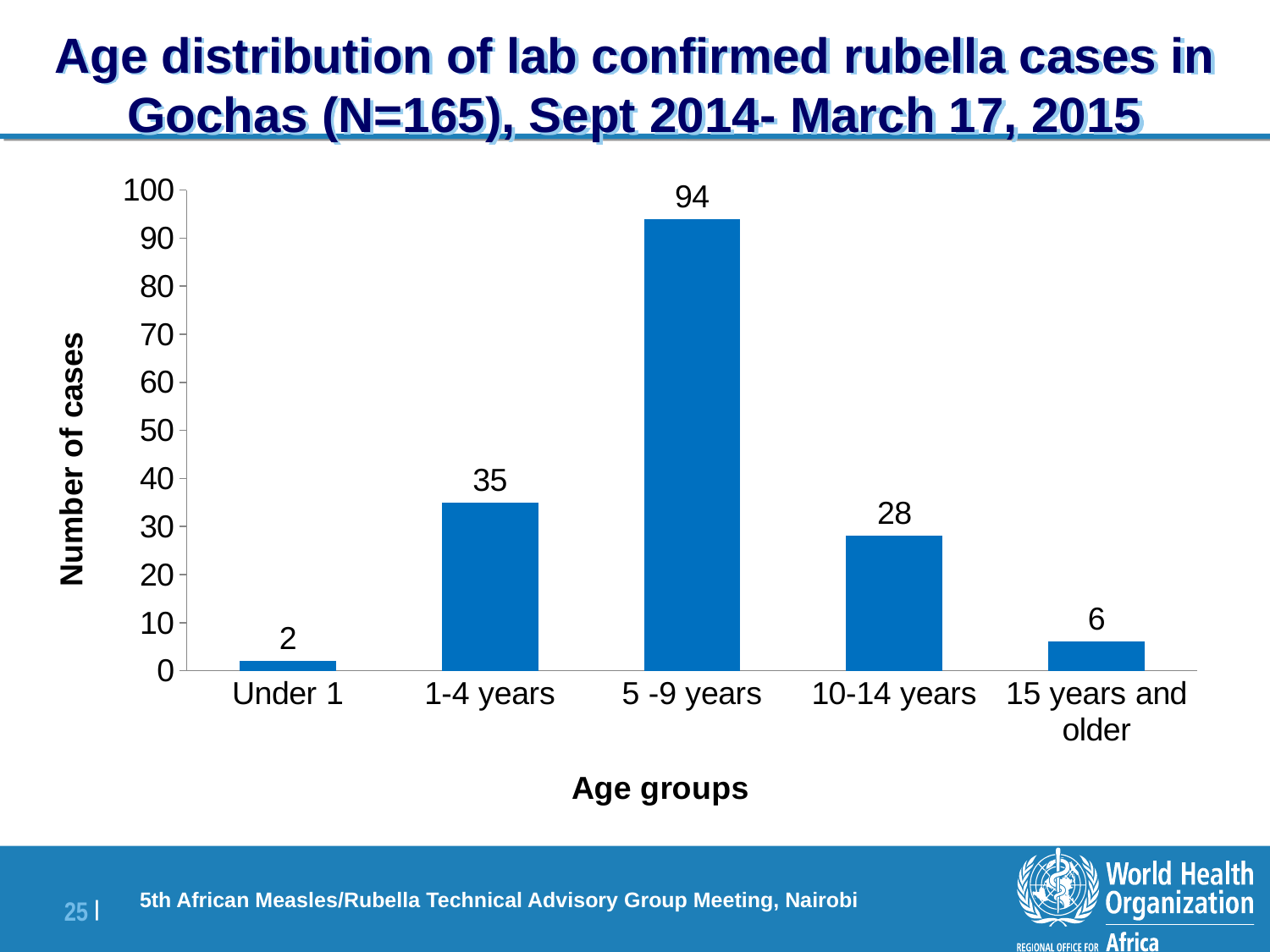
What is the label of the x axis? Age groups Which age group has more cases, 1-4 years or 10-14 years? 1-4 years What is the label of the y axis? Number of cases What is the difference in number of cases between the 5 -9 years and 10-14 years age groups? 66 Is the value for the 10-14 years age group greater or less than 30? less How many cases are shown for the 15 years and older age group? 6 Which age group has the highest number of cases? 5 -9 years Which age group has the lowest number of cases? Under 1 How many lab confirmed rubella cases are shown for the 5 -9 years age group? 94 What is the number of cases for the 1-4 years age group? 35 What kind of chart is shown on the slide? bar chart How many age groups are shown on the x axis? 5